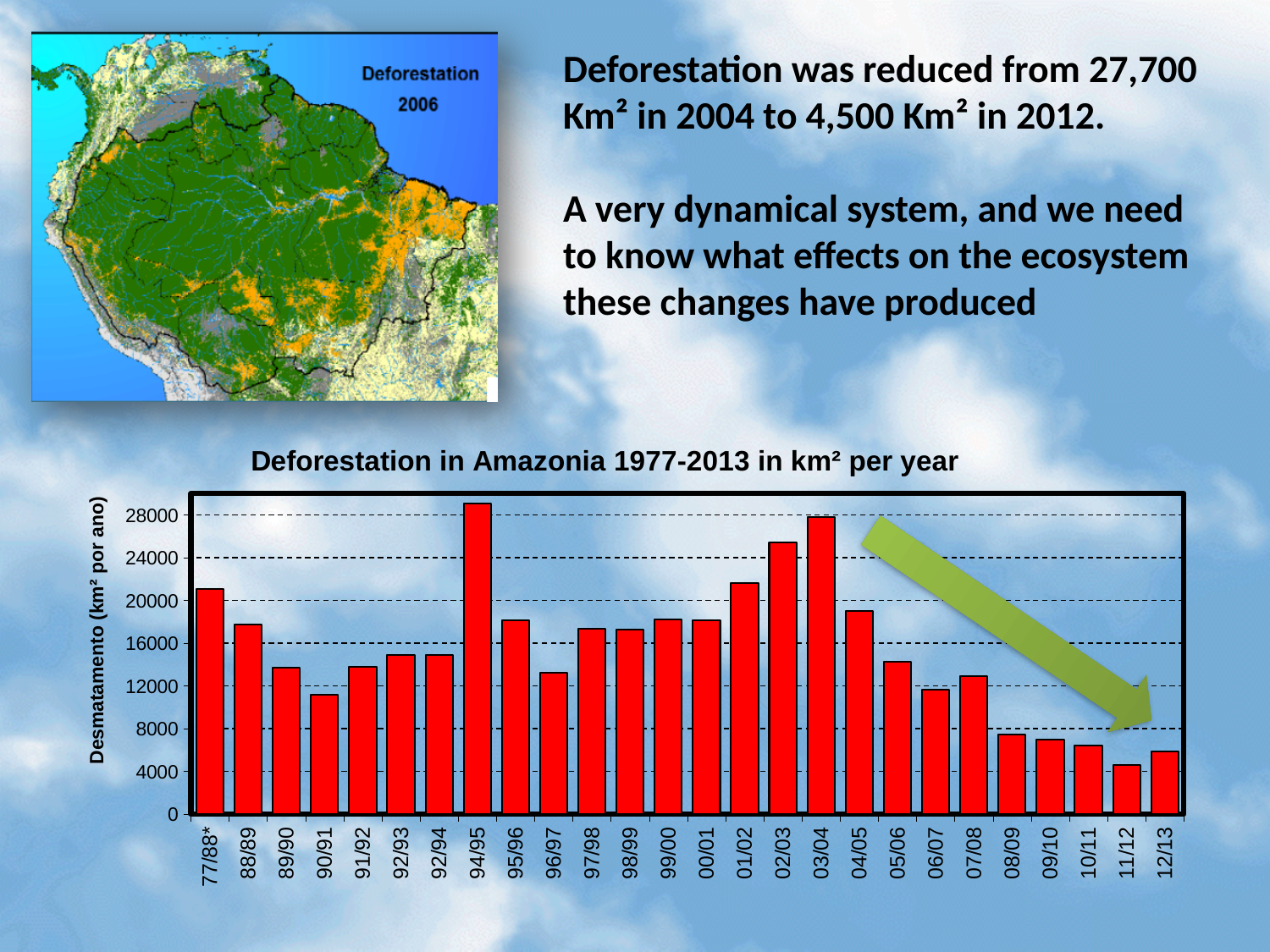
Is the value for 03/04 greater or less than 24000? greater Which year category has the lowest deforestation value in the chart? 11/12 How many bars (year categories) are plotted in the chart? 26 What kind of chart is shown on the slide? bar chart Do the values rise or fall from 04/05 to 12/13? fall Is the value for 08/09 greater or less than 8000? less What is the label of the vertical axis of the chart? Desmatamento (km² por ano) Is the value for 77/88* greater or less than 20000? greater What is the title of the chart on the slide? Deforestation in Amazonia 1977-2013 in km² per year Which is larger, the value for 03/04 or the value for 02/03? 03/04 Which year category has the highest deforestation value in the chart? 94/95